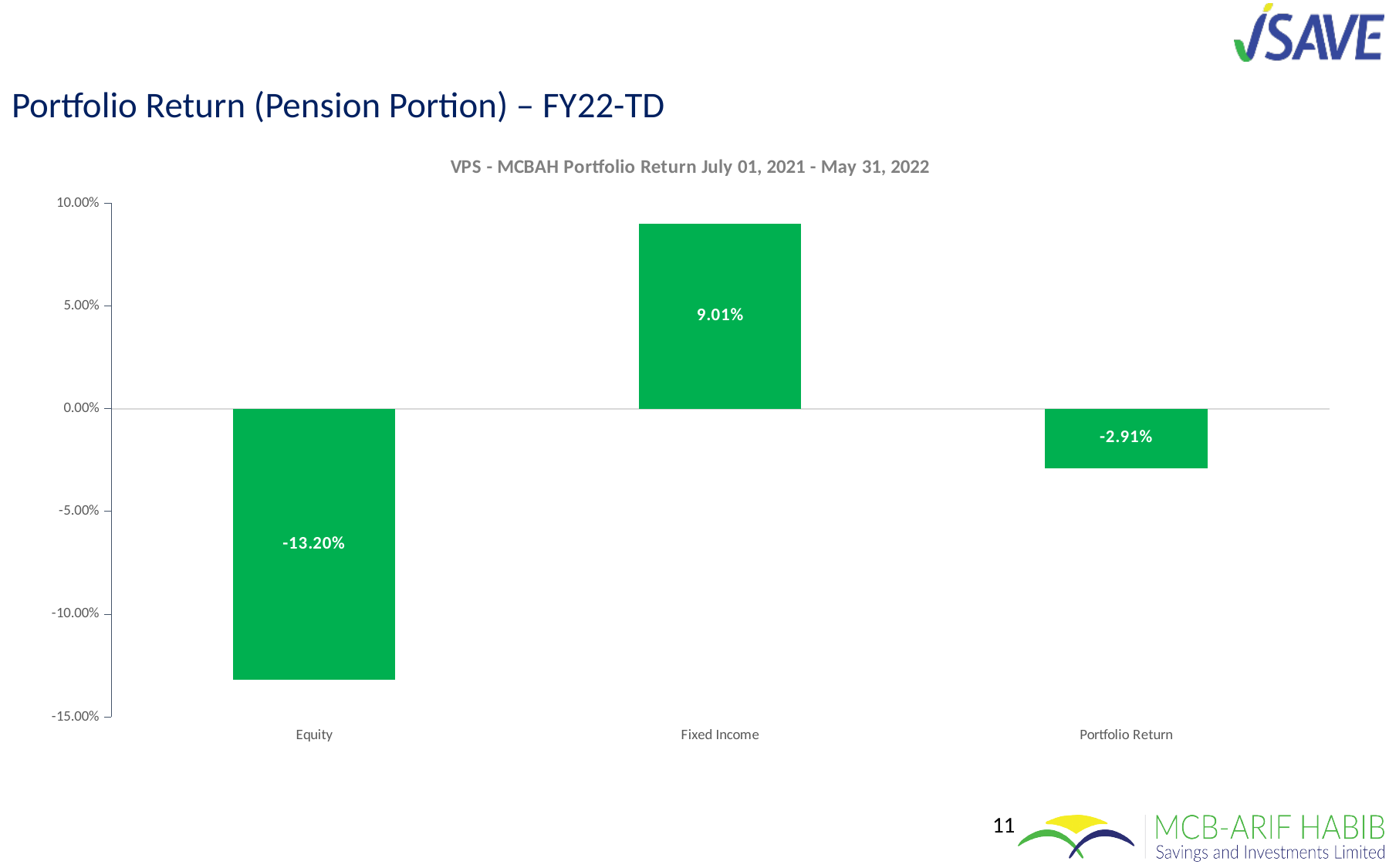
Is the value for Equity greater or less than -10.00%? less What is the value for Fixed Income? 9.01% Which category has the lowest value? Equity Which category has the highest value? Fixed Income What is the title of the chart? VPS - MCBAH Portfolio Return July 01, 2021 - May 31, 2022 What is the value for Portfolio Return? -2.91% Which is larger, the value for Equity or the value for Portfolio Return? Portfolio Return What is the value for Equity? -13.20% What kind of chart is shown on the slide? bar chart What is the difference between the Fixed Income value and the Portfolio Return value? 11.92% How many categories are shown on the x axis? 3 Is the value for Fixed Income greater or less than 5.00%? greater